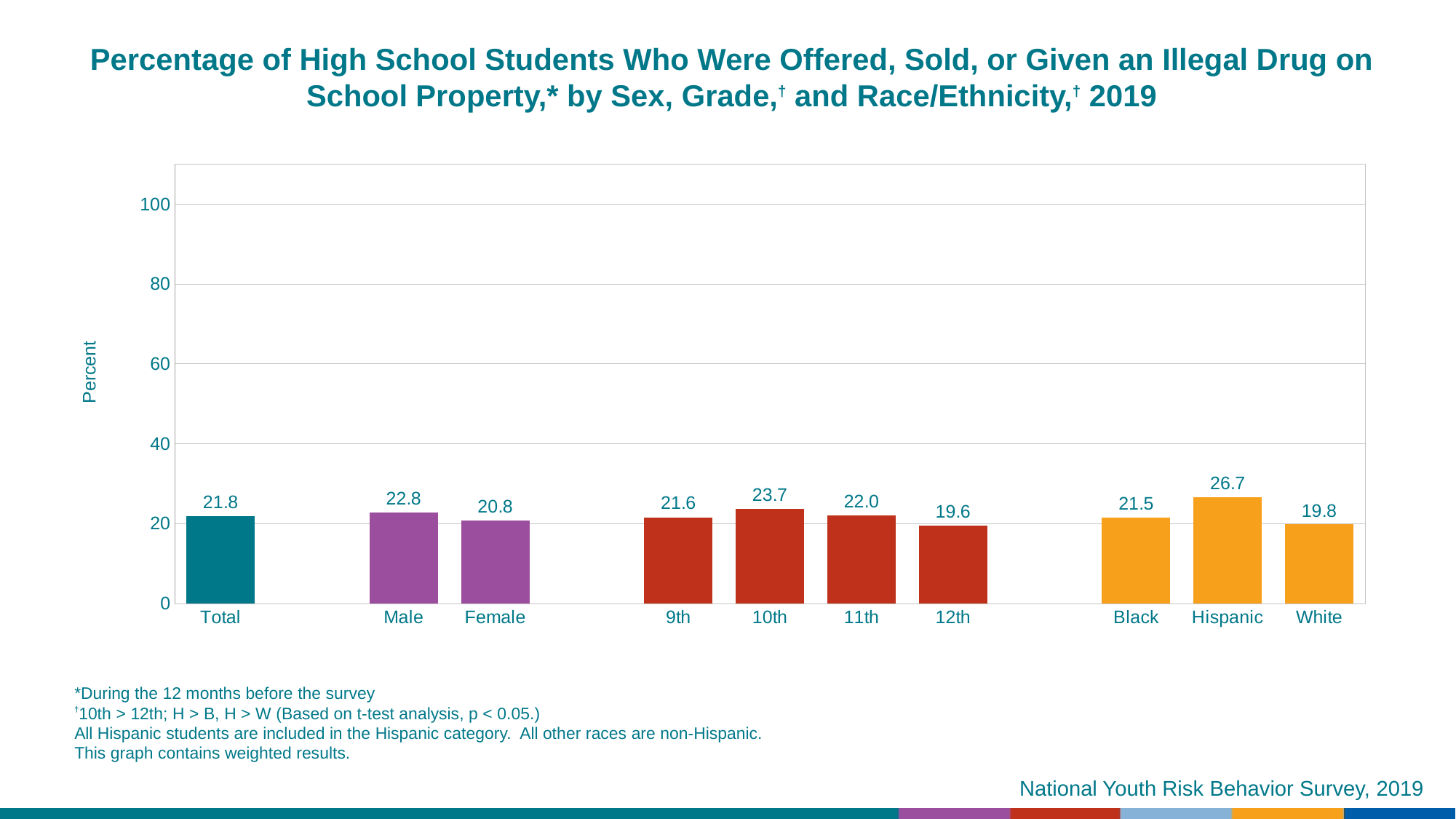
Which is larger, the value for 10th grade or the value for 12th grade? 10th Which category has the highest value? Hispanic Which category has the lowest value? 12th What is the label on the y axis? Percent What is the difference between the Male and Female values? 2.0 How many categories are shown on the x axis? 10 What is the difference between the Hispanic and White values? 6.9 What is the value for 12th grade? 19.6 What is the value for Total? 21.8 What kind of chart is this? bar chart What is the value for Hispanic students? 26.7 Is the value for Hispanic greater or less than 40? less